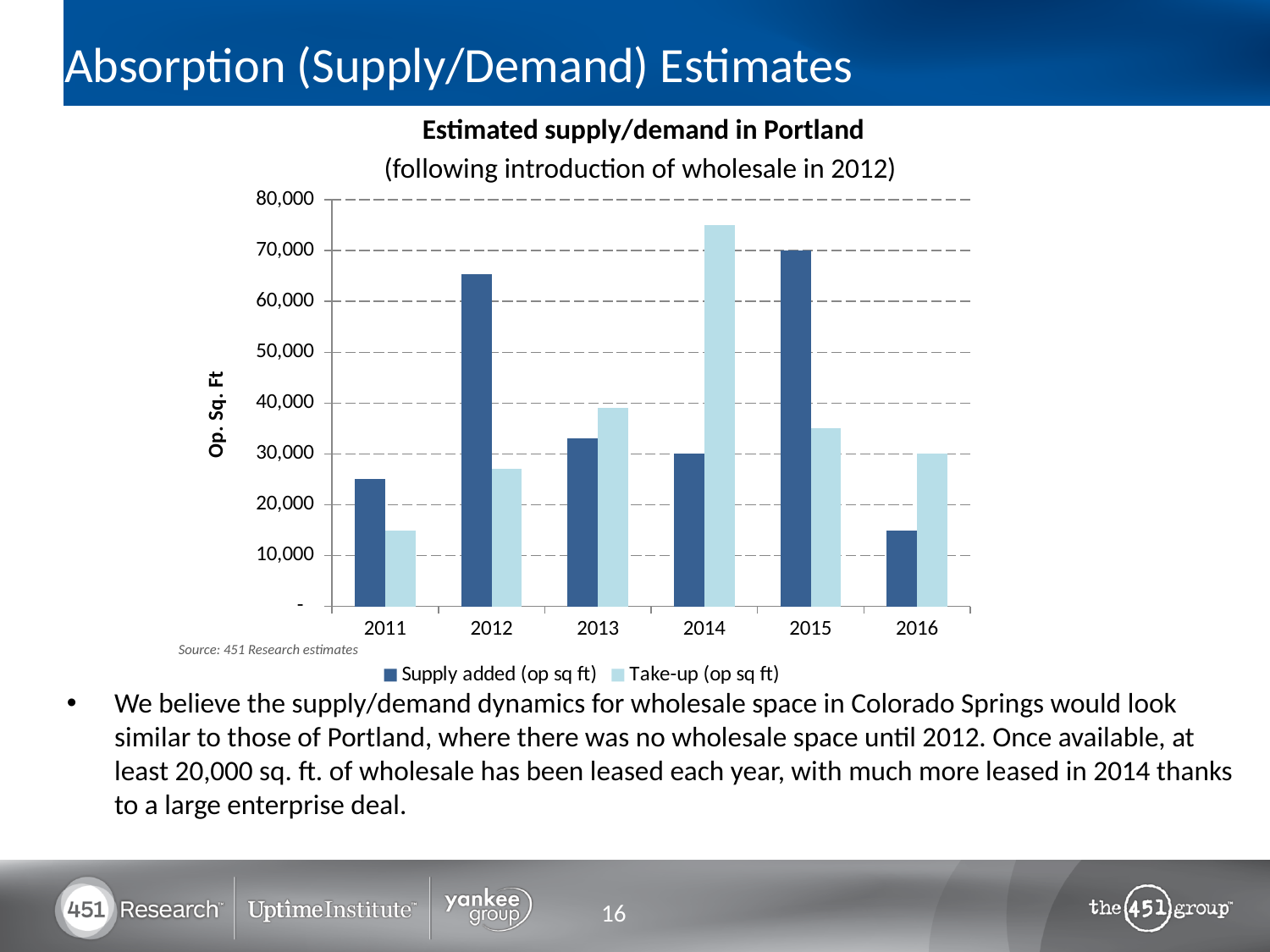
In 2014, which was larger: Supply added or Take-up? Take-up In which year was Supply added (op sq ft) the highest? 2015 Is the Supply added value for 2012 greater or less than 60,000? greater In 2012, which was larger: Supply added or Take-up? Supply added In which year was Supply added (op sq ft) the lowest? 2016 How many series does the legend list? 2 What type of chart is shown on the slide? Bar chart In which year was Take-up (op sq ft) the lowest? 2011 What is the label on the vertical axis of the chart? Op. Sq. Ft Is the Take-up value for 2011 greater or less than 20,000? less In which year was Take-up (op sq ft) the highest? 2014 How many years are shown along the x axis? 6